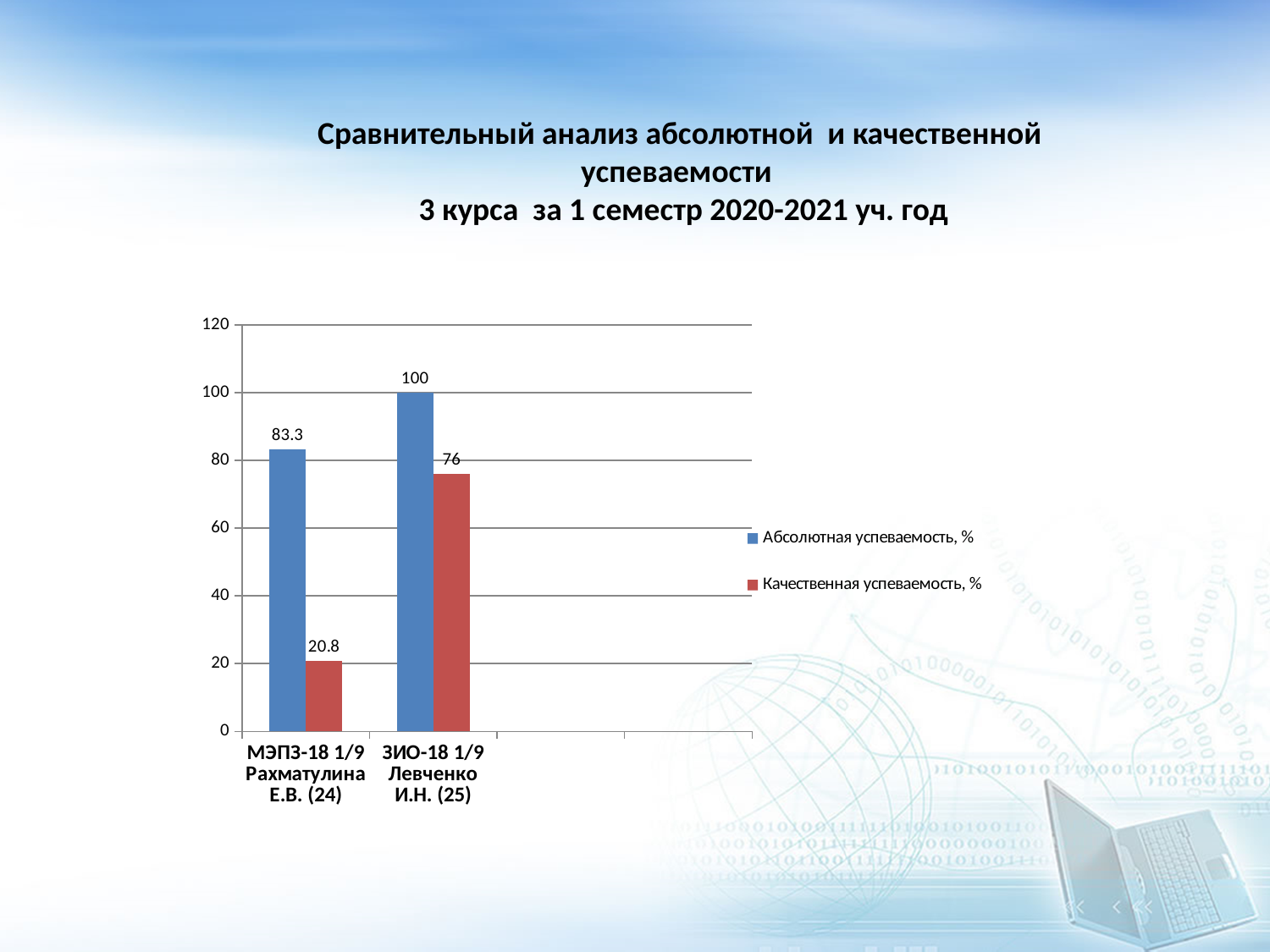
Which group has the higher Качественная успеваемость, %? ЗИО-18 1/9 Левченко И.Н. (25) What is the value of Абсолютная успеваемость, % for МЭПЗ-18 1/9 Рахматулина Е.В. (24)? 83.3 What is the value of Абсолютная успеваемость, % for ЗИО-18 1/9 Левченко И.Н. (25)? 100 What is the difference in Абсолютная успеваемость, % between ЗИО-18 1/9 and МЭПЗ-18 1/9? 16.7 What is the difference in Качественная успеваемость, % between ЗИО-18 1/9 and МЭПЗ-18 1/9? 55.2 Which group has the lower Абсолютная успеваемость, %? МЭПЗ-18 1/9 Рахматулина Е.В. (24) Is the Абсолютная успеваемость, % for МЭПЗ-18 1/9 greater or less than 80? greater How many series does the legend list? 2 How many groups are shown on the x axis of the chart? 2 What is the value of Качественная успеваемость, % for МЭПЗ-18 1/9 Рахматулина Е.В. (24)? 20.8 What is the value of Качественная успеваемость, % for ЗИО-18 1/9 Левченко И.Н. (25)? 76 What kind of chart is shown on the slide? bar chart